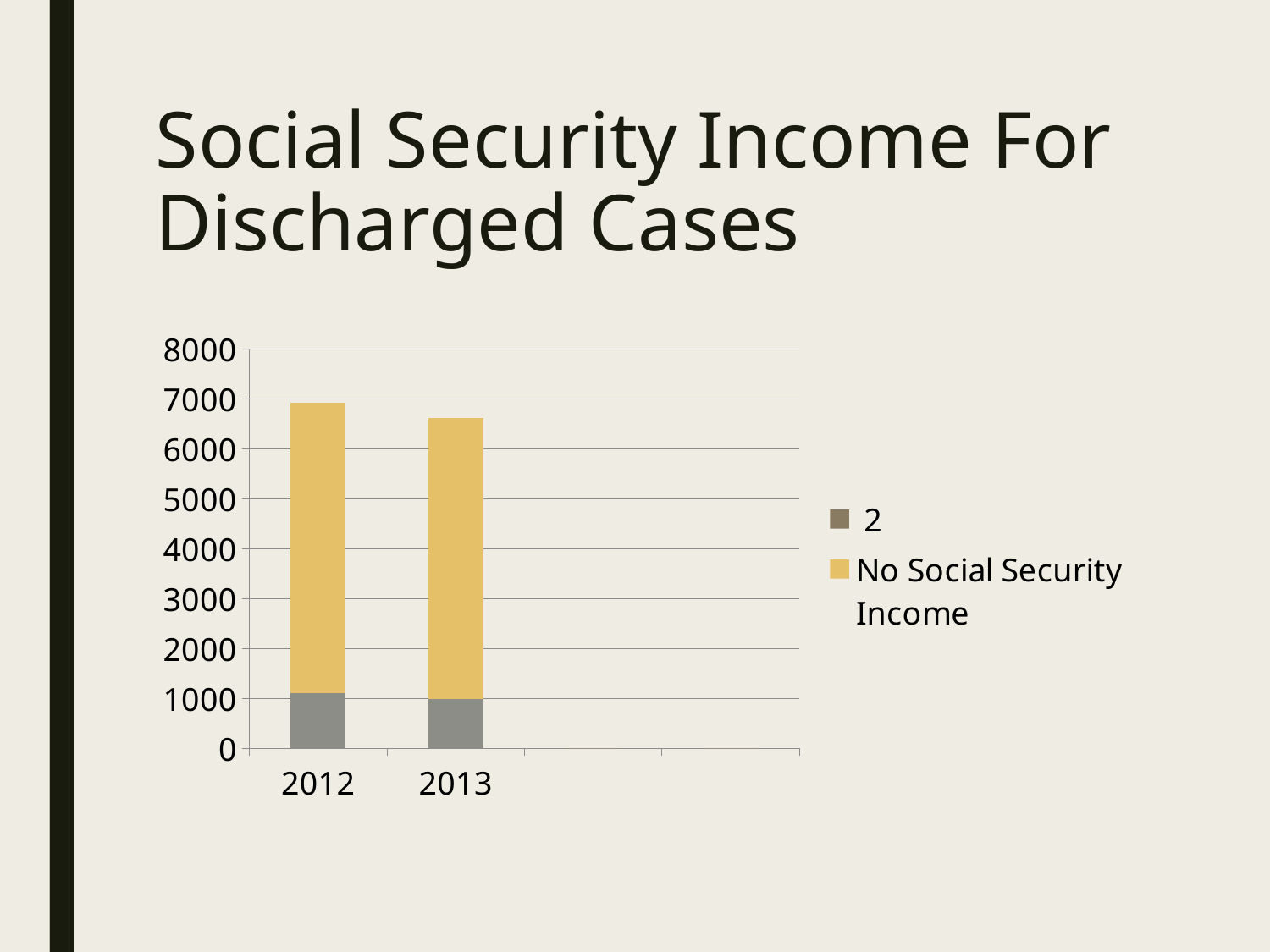
Is the 'No Social Security Income' segment of the 2013 bar greater or less than 5000? greater Which series makes up the larger part of the 2012 bar, '2' or 'No Social Security Income'? No Social Security Income Is the total height of the 2013 bar greater or less than 7000? less What kind of chart is shown on the slide? stacked bar chart How many series does the chart's legend list? 2 Is the total height of the 2012 bar greater or less than 7000? less Does the total bar height rise or fall from 2012 to 2013? fall How many categories are shown on the x axis of the chart? 2 Which series is shown in yellow in the chart? No Social Security Income Which years are shown on the x axis of the chart? 2012 and 2013 Which year has the taller stacked bar, 2012 or 2013? 2012